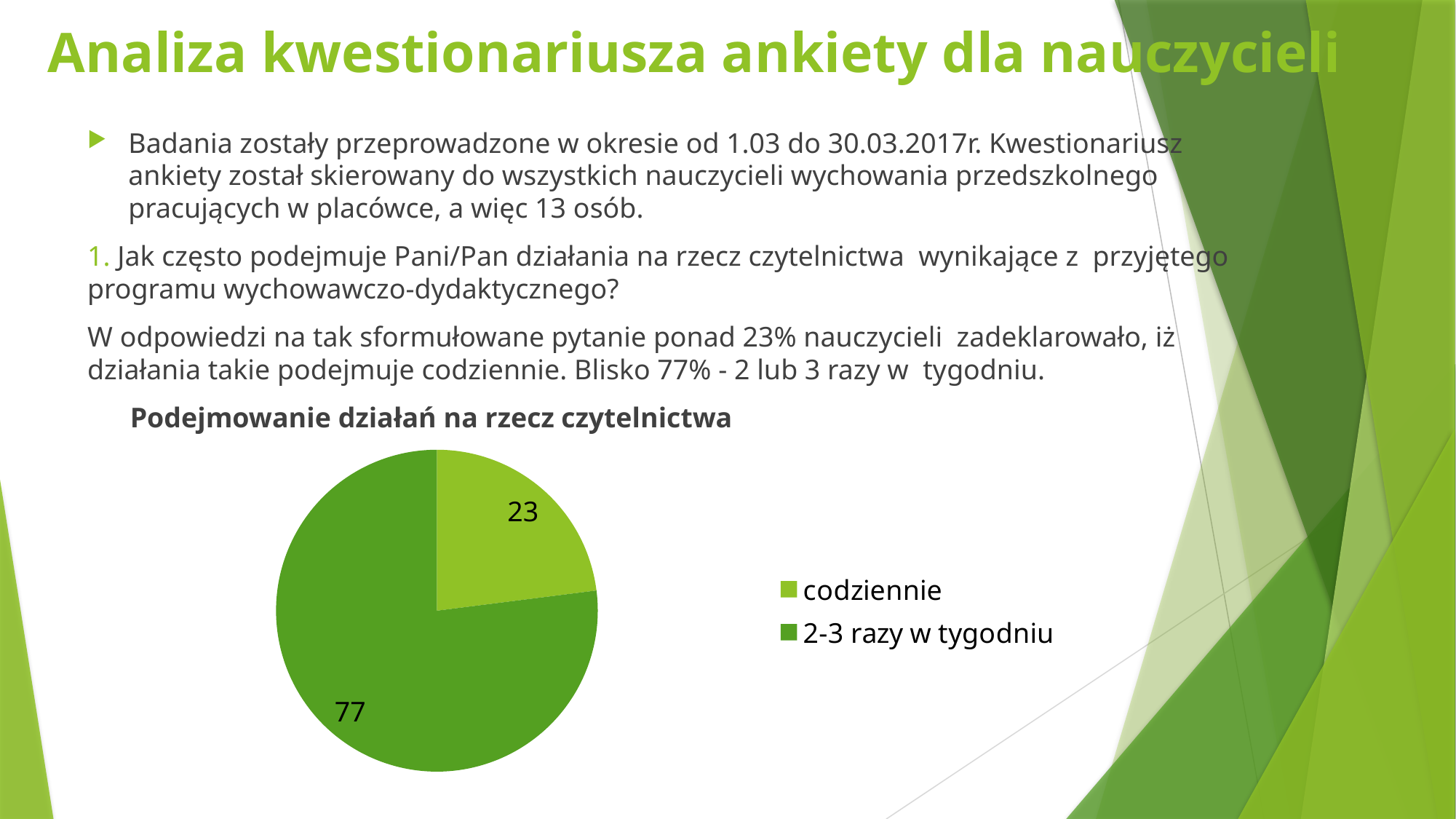
How many entries does the legend list? 2 What is the difference between the values for "2-3 razy w tygodniu" and "codziennie"? 54 Which category has the smallest slice in the pie chart? codziennie How many categories does the pie chart show? 2 What is the value for "codziennie" in the pie chart? 23 What type of chart is shown on the slide? pie chart Which category has the largest slice in the pie chart? 2-3 razy w tygodniu What share of the pie does the "codziennie" slice represent? 23% Which is larger: the value for "codziennie" or the value for "2-3 razy w tygodniu"? 2-3 razy w tygodniu What is the total of the two values shown in the pie chart? 100 What is the title of the chart? Podejmowanie działań na rzecz czytelnictwa What is the value for "2-3 razy w tygodniu" in the pie chart? 77